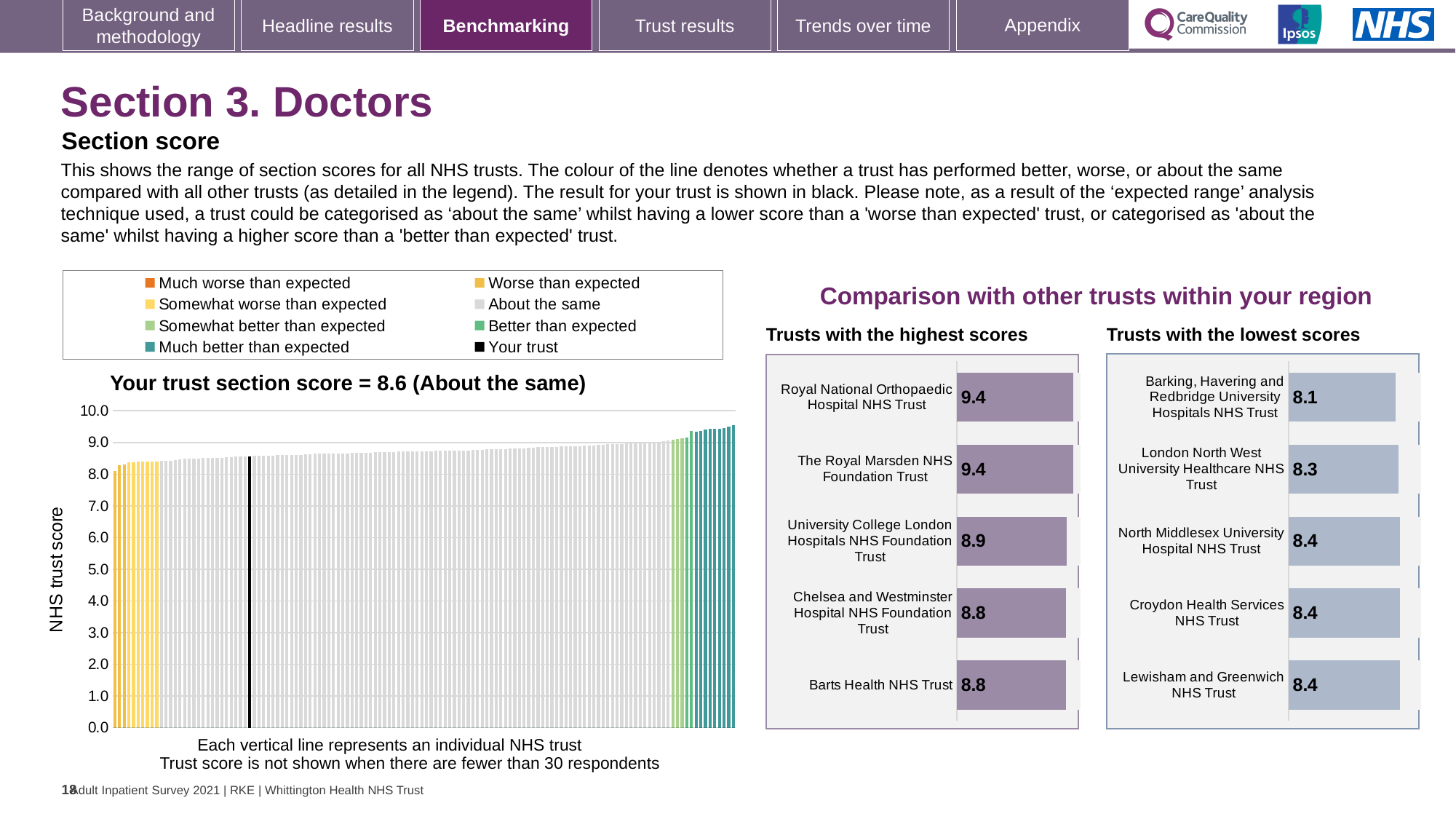
In the 'Trusts with the lowest scores' chart, what is the score for Barking, Havering and Redbridge University Hospitals NHS Trust? 8.1 What kind of chart is the 'Your trust section score' chart on the left? Bar chart In the 'Trusts with the lowest scores' chart, which trust has the lowest score? Barking, Havering and Redbridge University Hospitals NHS Trust In the 'Trusts with the highest scores' chart, what is the difference between the scores of Royal National Orthopaedic Hospital NHS Trust and Barts Health NHS Trust? 0.6 In the 'Trusts with the lowest scores' chart, what is the difference between the scores of London North West University Healthcare NHS Trust and Barking, Havering and Redbridge University Hospitals NHS Trust? 0.2 In the 'Trusts with the highest scores' chart, which has the higher score: University College London Hospitals NHS Foundation Trust or Chelsea and Westminster Hospital NHS Foundation Trust? University College London Hospitals NHS Foundation Trust According to the title of the chart on the left, what is your trust's section score? 8.6 (About the same) How many trusts are shown in the 'Trusts with the lowest scores' chart? 5 In the 'Trusts with the highest scores' chart, what is the score for University College London Hospitals NHS Foundation Trust? 8.9 How many entries does the legend of the 'Your trust section score' chart list? 8 In the 'Your trust section score' chart, do the trust scores rise or fall from left to right along the x axis? Rise How many trusts are shown in the 'Trusts with the highest scores' chart? 5